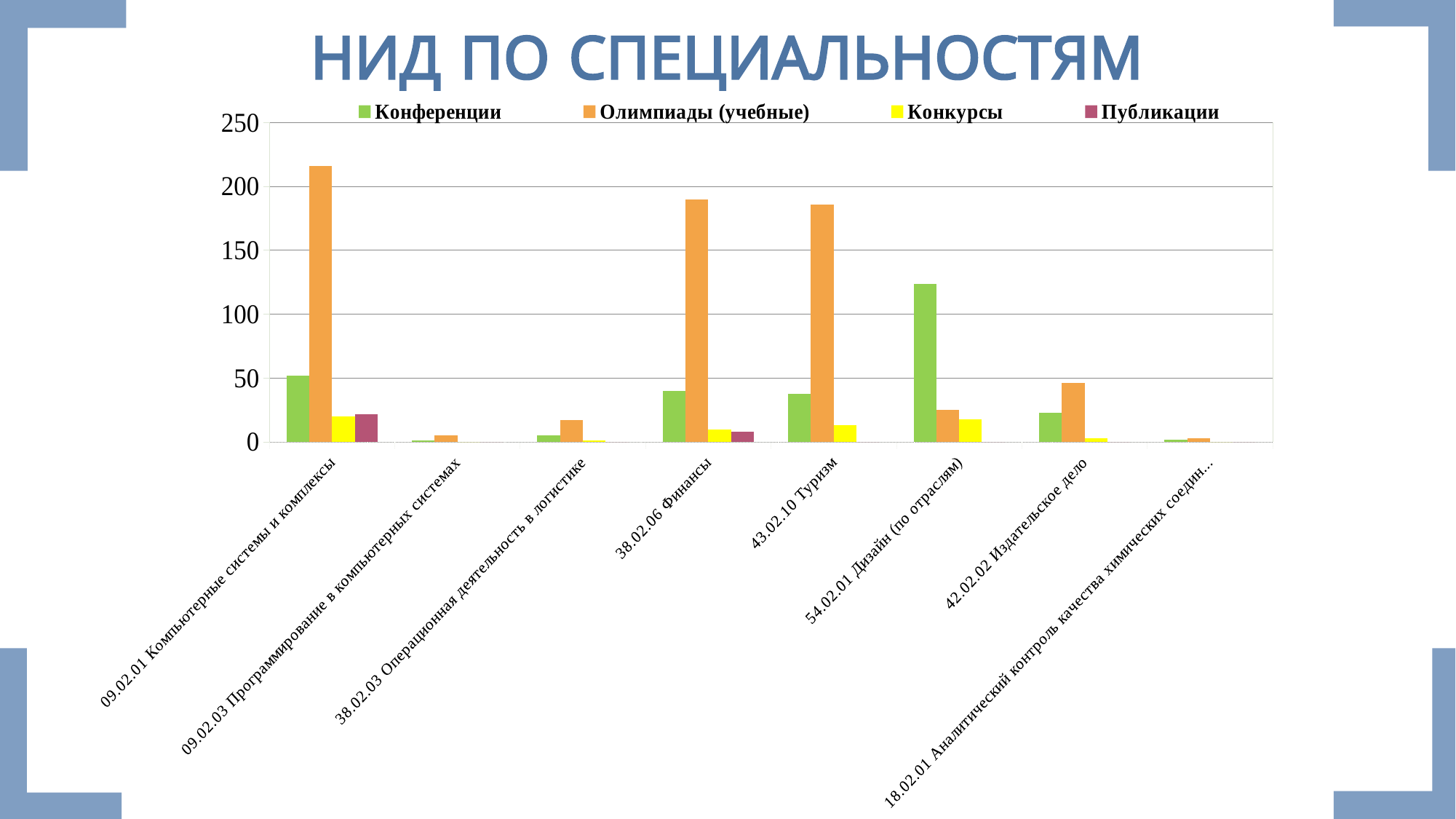
Is the Олимпиады (учебные) value for 43.02.10 Туризм greater or less than 150? greater Which specialty has the highest value for Олимпиады (учебные)? 09.02.01 Компьютерные системы и комплексы Is the Конференции value for 54.02.01 Дизайн (по отраслям) greater or less than 100? greater How many specialties (categories) are shown on the x axis? 8 Which is larger: the Олимпиады (учебные) value for 38.02.06 Финансы or for 54.02.01 Дизайн (по отраслям)? 38.02.06 Финансы Which specialty has the highest value for Конференции? 54.02.01 Дизайн (по отраслям) What is the title of the slide? НИД ПО СПЕЦИАЛЬНОСТЯМ Is the Олимпиады (учебные) value for 09.02.01 Компьютерные системы и комплексы greater or less than 200? greater Which is larger: the Конкурсы value for 54.02.01 Дизайн (по отраслям) or for 38.02.06 Финансы? 54.02.01 Дизайн (по отраслям) How many series does the legend list? 4 What kind of chart is shown on the slide? bar chart